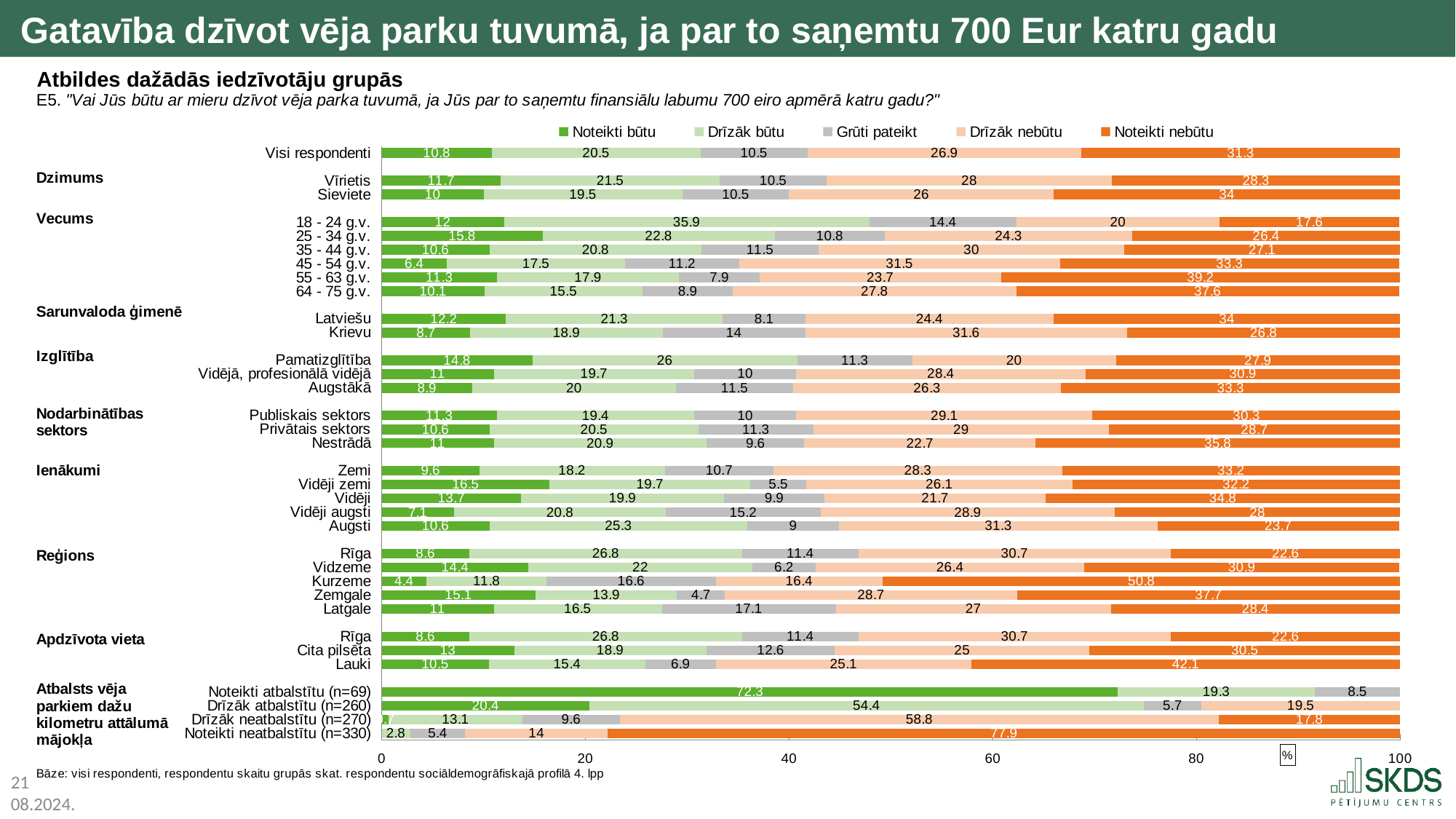
What is the difference between the "Noteikti nebūtu" values for Sieviete and Vīrietis? 5.7 What colour represents the "Noteikti nebūtu" series in the chart? Orange What kind of chart is shown on the slide? Stacked bar chart What is the value of "Noteikti nebūtu" for Lauki? 42.1 What is the value of "Noteikti nebūtu" for "Visi respondenti"? 31.3 Which has the larger "Noteikti nebūtu" value, Vīrietis or Sieviete? Sieviete How many series does the legend list? 5 What is the value of "Noteikti būtu" for "Noteikti atbalstītu (n=69)"? 72.3 Among the Reģions groups, which region has the highest "Noteikti nebūtu" value? Kurzeme What is the value of "Drīzāk būtu" for the 18 - 24 g.v. group? 35.9 What is the value of "Noteikti nebūtu" for Kurzeme? 50.8 Among the Vecums (age) groups, which has the lowest "Noteikti būtu" value? 45 - 54 g.v.